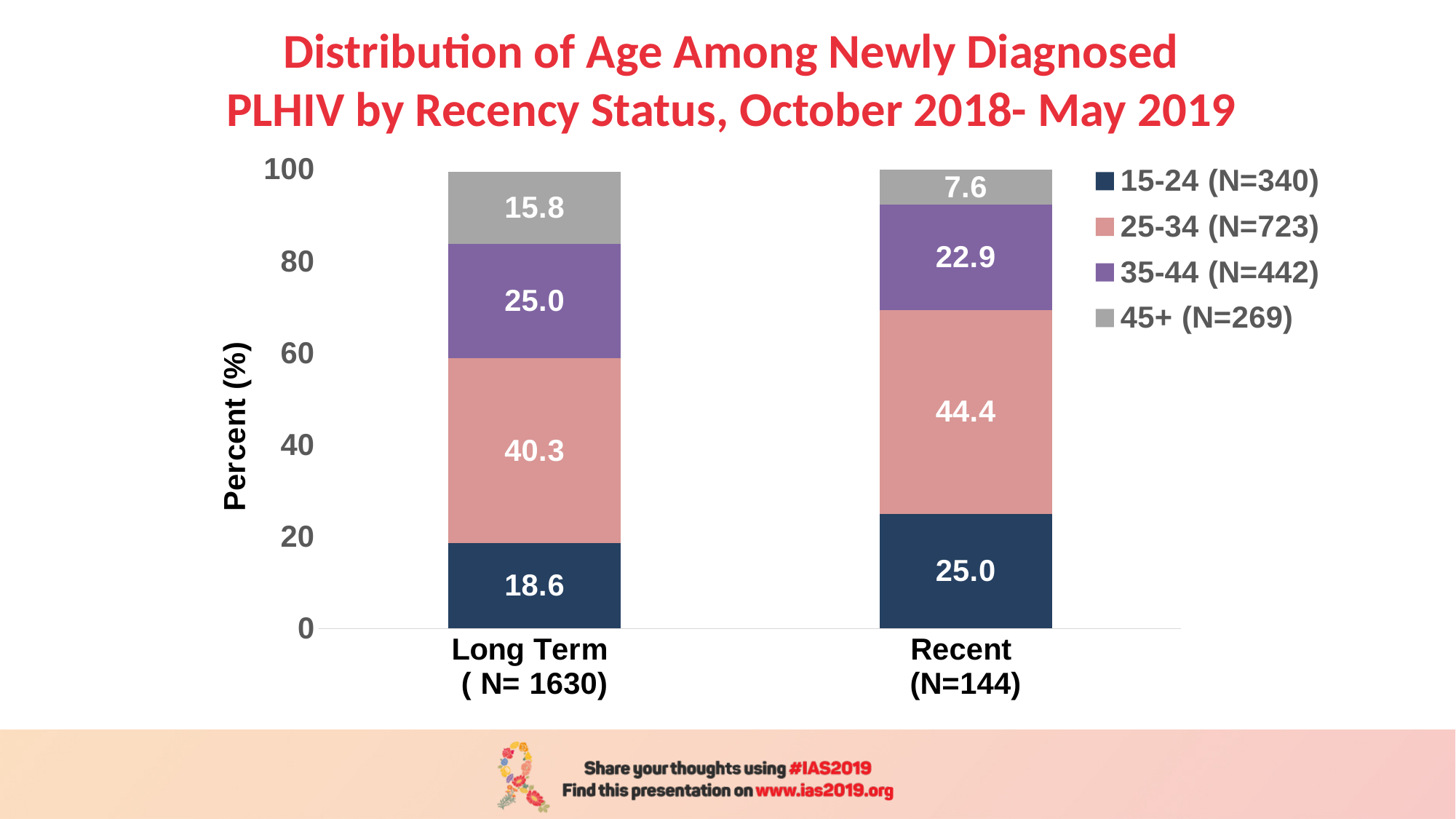
What is the value for the 45+ age group in the Recent bar? 7.6 What is the value for the 35-44 age group in the Long Term bar? 25.0 Which age group has the largest share in the Long Term bar? 25-34 What is the label of the y axis? Percent (%) What is the value for the 25-34 age group in the Recent bar? 44.4 What is the value for the 15-24 age group in the Long Term bar? 18.6 What is the difference between the 25-34 values for Recent and Long Term? 4.1 What kind of chart is this? Stacked bar chart How many series does the legend list? 4 Which is larger: the 45+ value for Long Term or for Recent? Long Term Which age group has the smallest share in the Recent bar? 45+ How many categories are shown on the x axis? 2